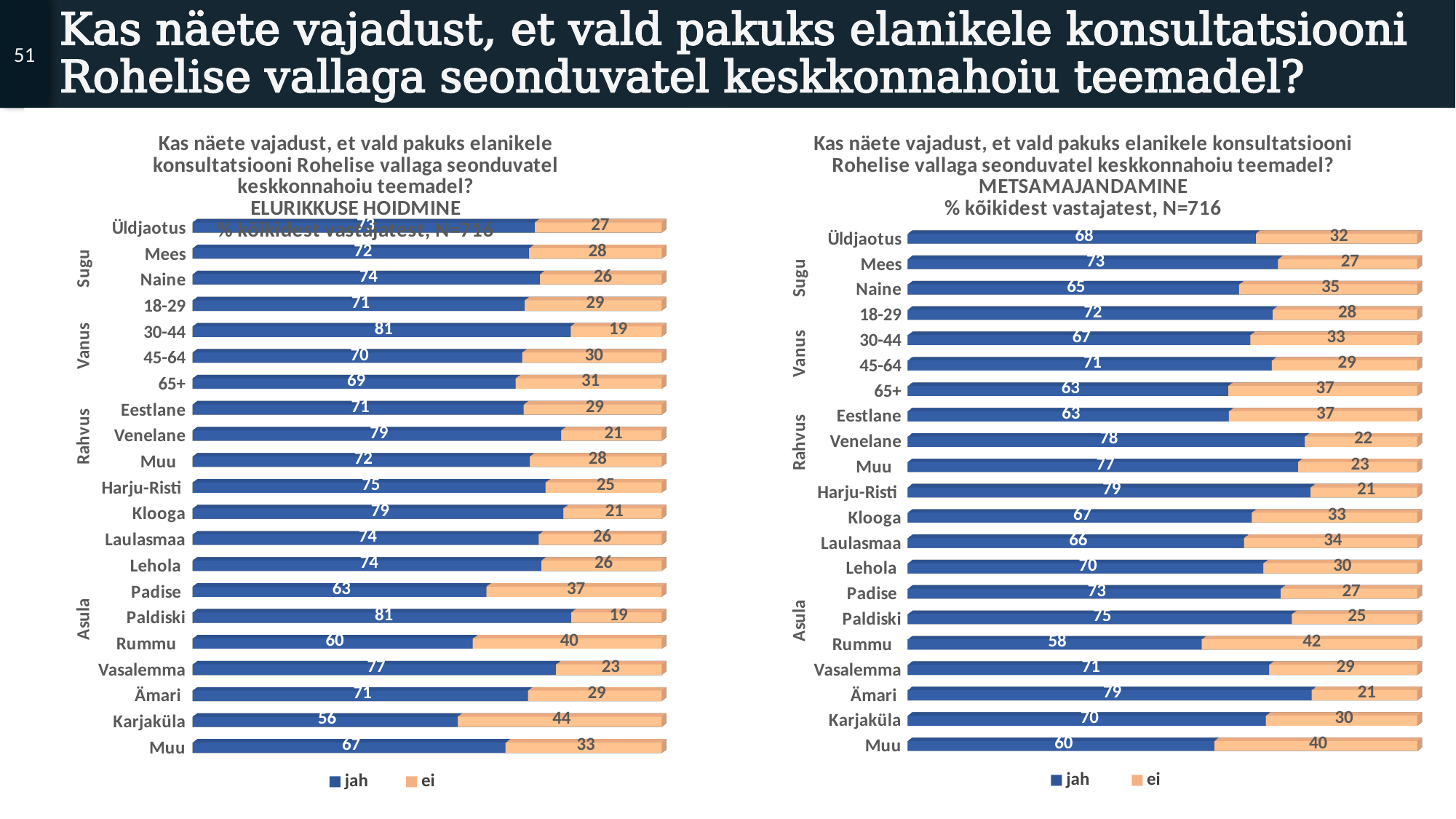
In the METSAMAJANDAMINE chart, what is the difference between the 'jah' values for Mees and Naine? 8 In the ELURIKKUSE HOIDMINE chart, which category has the lowest 'jah' value? Karjaküla In the ELURIKKUSE HOIDMINE chart, which has a larger 'jah' value, Rummu or Vasalemma? Vasalemma In the METSAMAJANDAMINE chart, what is the 'ei' value for Naine? 35 In the METSAMAJANDAMINE chart, which category has the highest 'ei' value? Rummu In the METSAMAJANDAMINE chart, what is the 'jah' value for Üldjaotus? 68 In the ELURIKKUSE HOIDMINE chart, what is the difference between the 'jah' values for Venelane and Eestlane? 8 In the METSAMAJANDAMINE chart, what is the total of the stacked bar for Lehola? 100 What kind of chart is the ELURIKKUSE HOIDMINE chart? Stacked bar chart In the ELURIKKUSE HOIDMINE chart, what is the 'ei' value for Karjaküla? 44 In the ELURIKKUSE HOIDMINE chart, what is the 'jah' value for Paldiski? 81 How many series does the legend of the METSAMAJANDAMINE chart list? 2